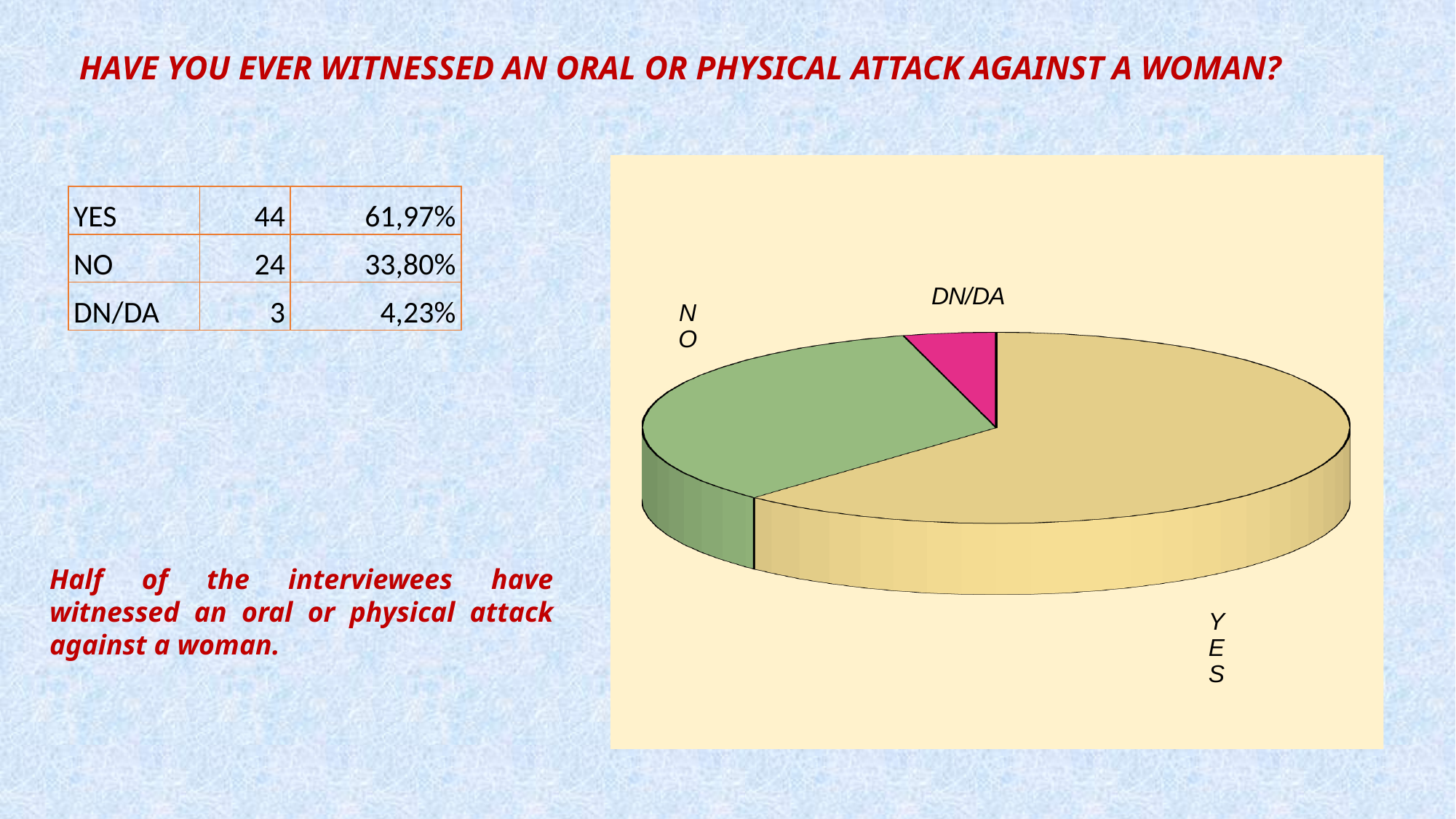
Which slice of the pie chart is the largest? YES What share of the pie does the NO slice represent, according to the table on the slide? 33,80% What share of the pie does the YES slice represent, according to the table on the slide? 61,97% What is the difference between the number of YES and NO responses shown in the table? 20 What kind of chart is shown on the slide? pie chart What share of the pie does the DN/DA slice represent, according to the table on the slide? 4,23% Which slice of the pie chart is the smallest? DN/DA How many respondents answered DN/DA, according to the table on the slide? 3 What colour is the DN/DA slice in the pie chart? pink How many slices does the pie chart have? 3 How many respondents answered YES, according to the table on the slide? 44 Which slice is larger in the pie chart, NO or DN/DA? NO